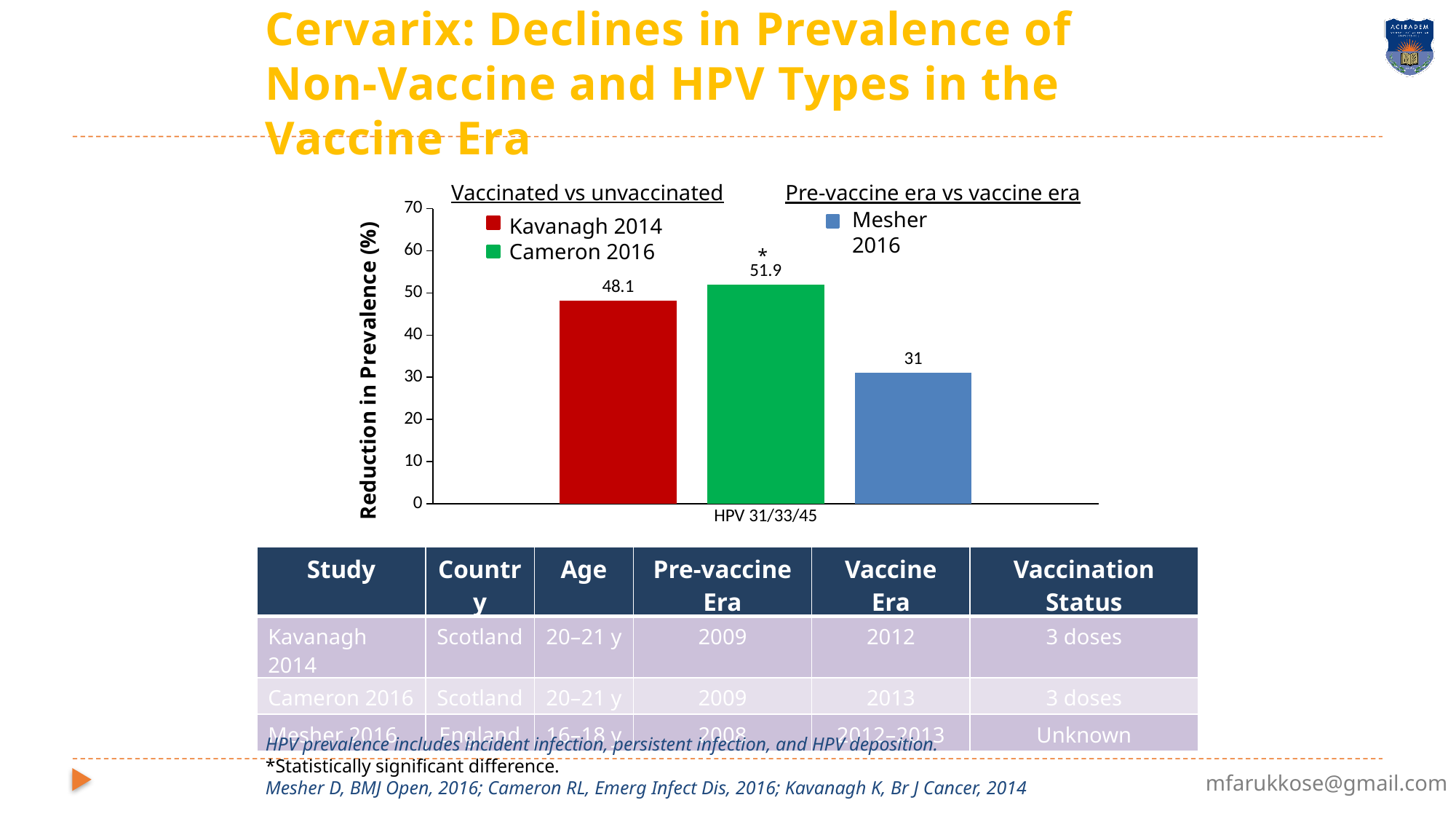
What is the reduction in prevalence for Mesher 2016? 31 Which is larger, the value for Kavanagh 2014 or the value for Mesher 2016? Kavanagh 2014 Is the value for Mesher 2016 greater or less than 40? less What is the label on the y axis of the chart? Reduction in Prevalence (%) Which study shows the lowest reduction in prevalence? Mesher 2016 What is the difference between the Cameron 2016 and Kavanagh 2014 values? 3.8 What kind of chart is shown on the slide? bar chart What is the reduction in prevalence for Kavanagh 2014? 48.1 What is the reduction in prevalence for Cameron 2016? 51.9 Which study shows the highest reduction in prevalence? Cameron 2016 What is the difference between the Kavanagh 2014 and Mesher 2016 values? 17.1 How many bars are plotted in the chart? 3